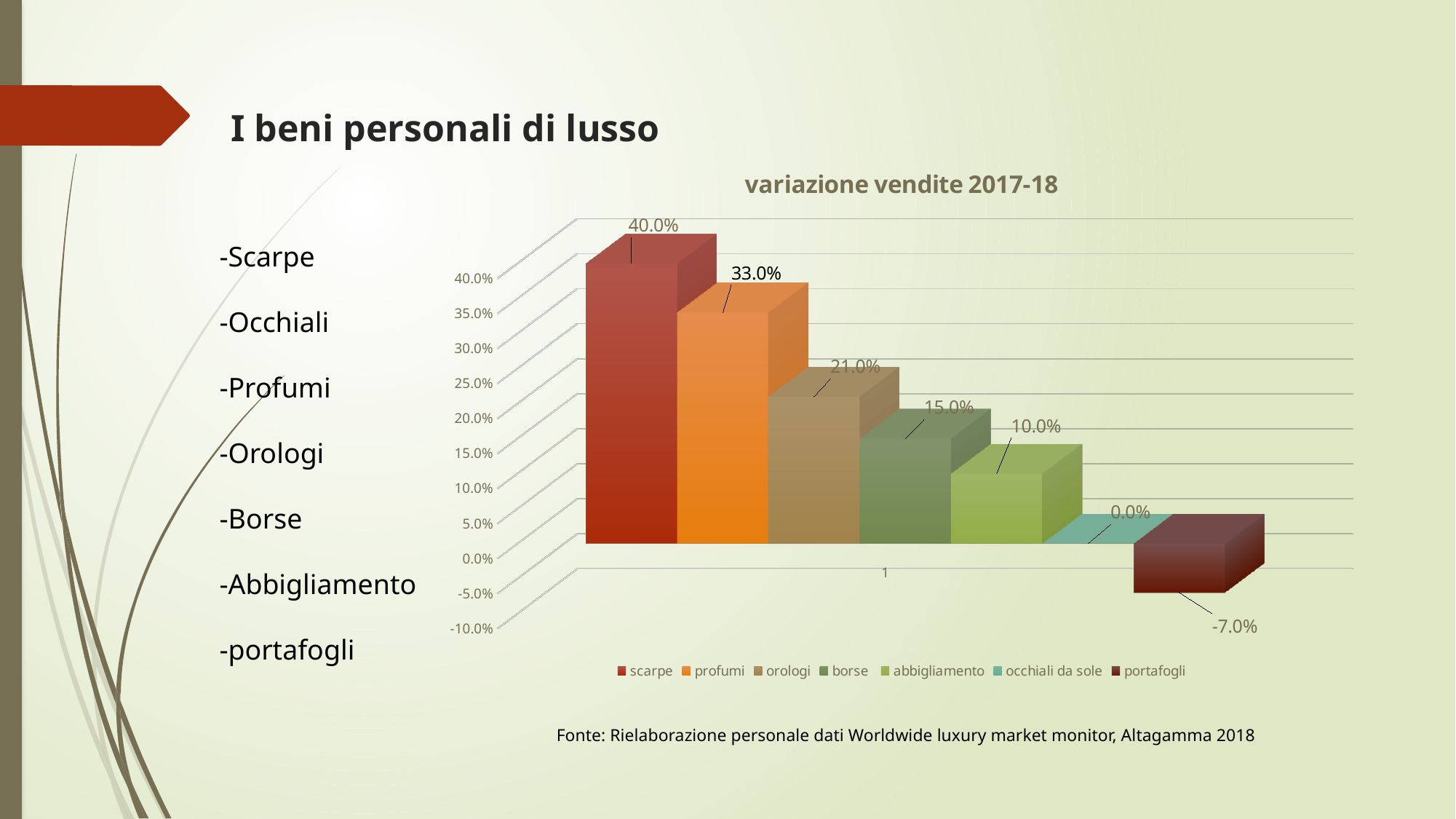
What is the difference between the values for scarpe and profumi? 7.0% What is the value for orologi in the chart? 21.0% Which is larger, the value for orologi or the value for borse? orologi How many series does the legend list? 7 What is the title of the chart? variazione vendite 2017-18 Which series has the lowest value in the chart? portafogli What is the value for scarpe in the chart? 40.0% What is the value for profumi in the chart? 33.0% What kind of chart is shown on the slide? bar chart Which series has the highest value in the chart? scarpe What is the difference between the values for borse and abbigliamento? 5.0% What is the value for portafogli in the chart? -7.0%